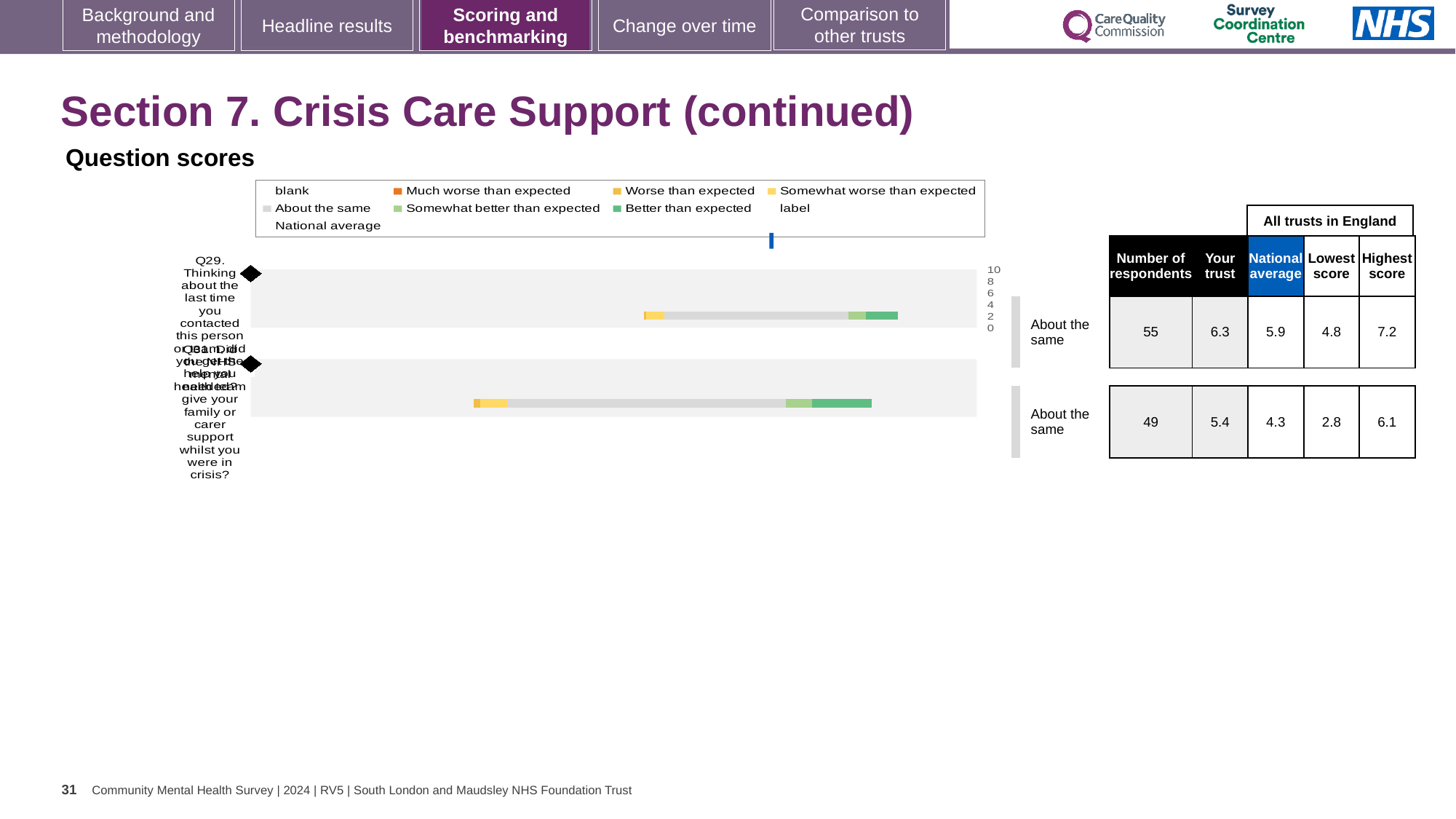
Which question has the higher 'Your trust' score, Q29 or Q31? Q29 What colour does the legend use for 'Better than expected'? green How many questions (bars) are plotted in the chart? 2 What is the difference in number of respondents between Q29 (55) and Q31 (49)? 6 What is the difference between the 'Your trust' score and the national average for Q29 (top row)? 0.4 How many respondents are listed for Q29 (top row) in the table? 55 What is the lowest score across all trusts in England for Q29 (top row)? 4.8 In the table beside the chart, what is the 'Your trust' score for Q29 (top row)? 6.3 What kind of chart is shown under 'Question scores'? bar chart What benchmark category is shown for both questions next to the chart? About the same What is the highest score across all trusts in England for Q31 (bottom row)? 6.1 In the table beside the chart, what is the national average for Q31 (bottom row)? 4.3